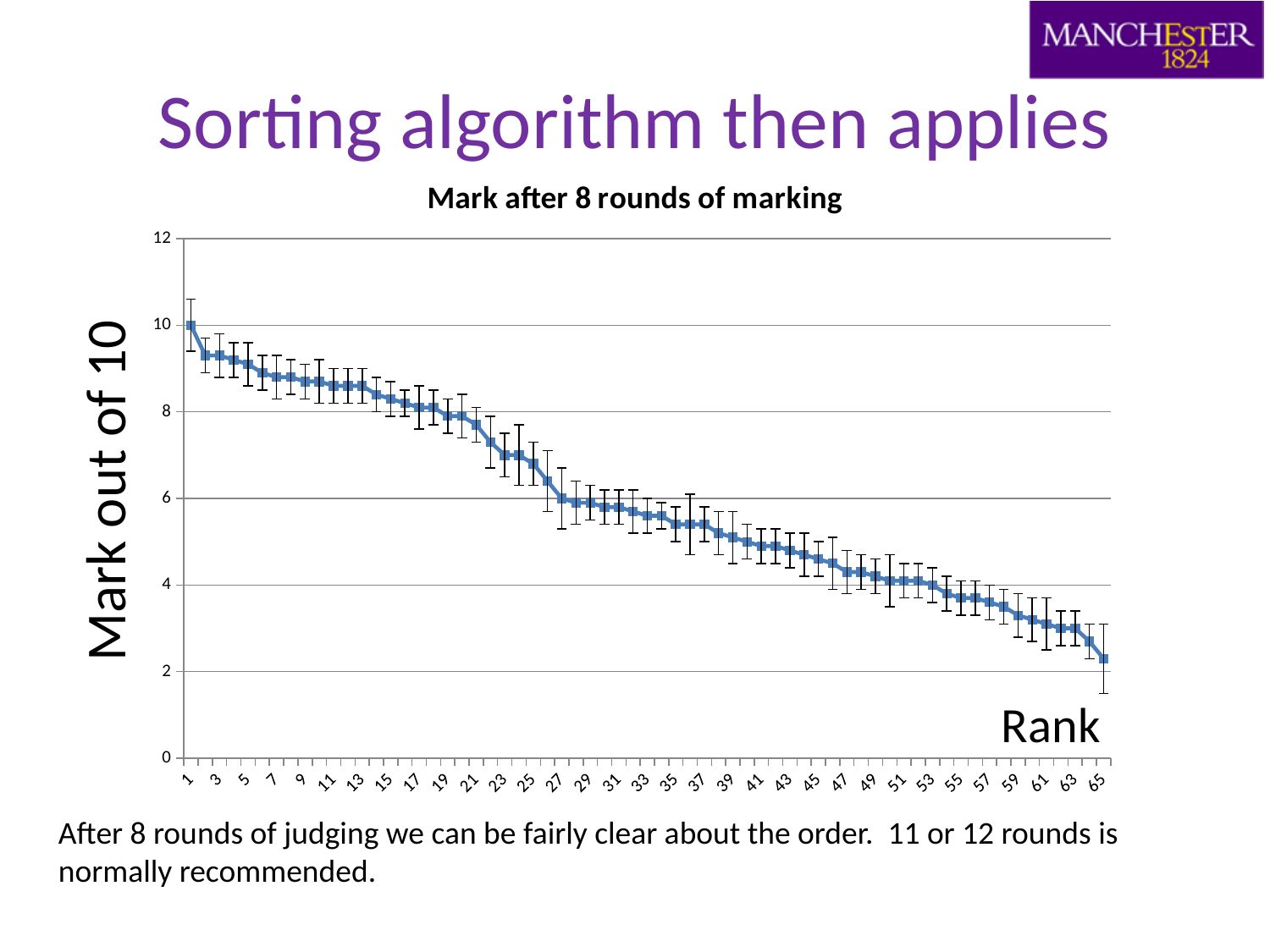
Which has the higher mark, rank 5 or rank 51? rank 5 Is the mark for rank 9 greater or less than 8? greater What is the mark for rank 1? 10 What is the title of the chart? Mark after 8 rounds of marking Do the marks rise or fall as rank increases along the x axis? fall What is the label on the vertical axis of the chart? Mark out of 10 Which rank has the highest mark? 1 What kind of chart is shown on the slide? line chart Is the mark for rank 65 greater or less than 4? less Is the mark for rank 27 greater or less than 8? less How many ranks are plotted on the chart? 65 Which rank has the lowest mark? 65